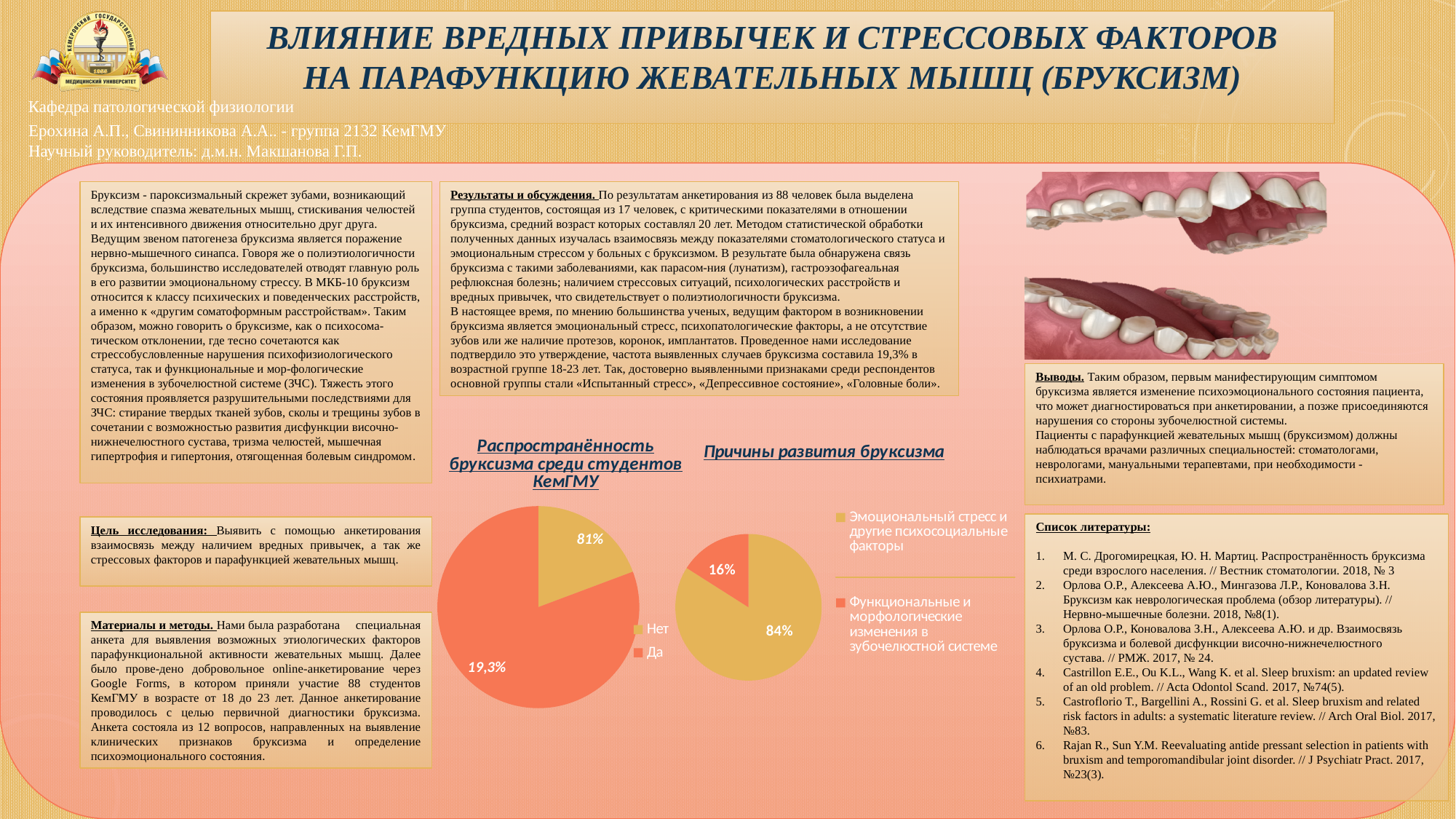
What kind of chart is 'Причины развития бруксизма'? Pie chart In the chart 'Причины развития бруксизма', which category has the smallest share? Функциональные и морфологические изменения в зубочелюстной системе What kind of chart is 'Распространённость бруксизма среди студентов КемГМУ'? Pie chart In the chart 'Причины развития бруксизма', which category has the largest share? Эмоциональный стресс и другие психосоциальные факторы In the chart 'Причины развития бруксизма', what share is shown for 'Функциональные и морфологические изменения в зубочелюстной системе'? 16% How many slices does the chart 'Причины развития бруксизма' have? 2 In the chart 'Распространённость бруксизма среди студентов КемГМУ', what are the legend entries? Нет, Да In the chart 'Причины развития бруксизма', what is the difference in percentage points between the two slices? 68 In the chart 'Распространённость бруксизма среди студентов КемГМУ', what are the two percentage labels printed on the pie? 81% and 19,3% In the chart 'Причины развития бруксизма', what share is shown for 'Эмоциональный стресс и другие психосоциальные факторы'? 84% In the chart 'Причины развития бруксизма', what colour is the slice for 'Функциональные и морфологические изменения в зубочелюстной системе'? Orange How many entries does the legend of the chart 'Распространённость бруксизма среди студентов КемГМУ' list? 2